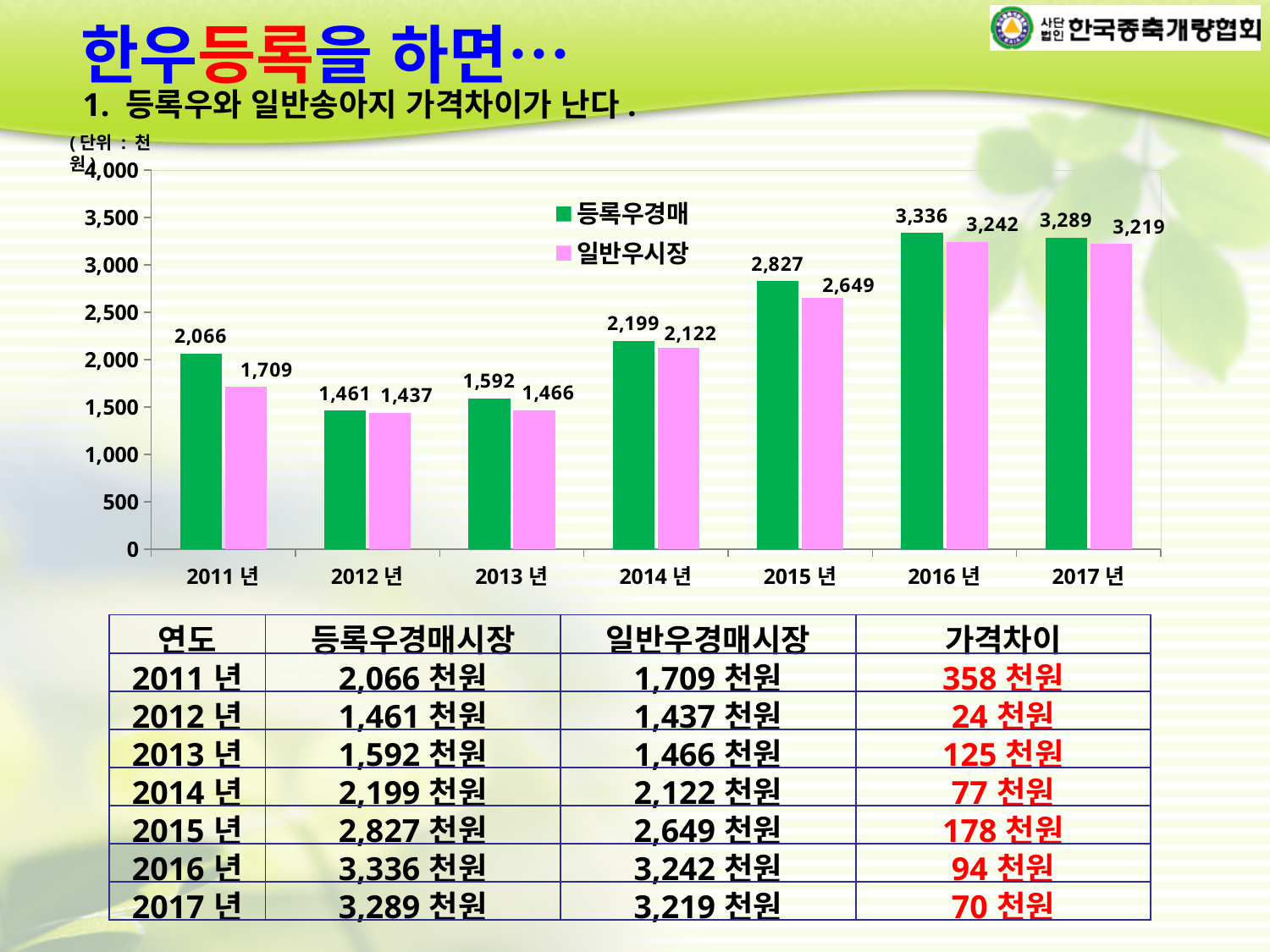
In which year is the 등록우경매 value highest? 2016 년 In which year is the 일반우시장 value lowest? 2012 년 What kind of chart is shown on the slide? bar chart What is the value for 등록우경매 in 2011 년? 2,066 What is the difference between 등록우경매 and 일반우시장 in 2015 년? 178 How many years are shown on the x axis of the chart? 7 How many series does the chart legend list? 2 What is the value for 일반우시장 in 2015 년? 2,649 What is the difference between 등록우경매 and 일반우시장 in 2011 년? 357 Is the value for 등록우경매 in 2013 년 greater or less than 1,500? greater Which is larger in 2014 년, 등록우경매 or 일반우시장? 등록우경매 What is the value for 일반우시장 in 2017 년? 3,219